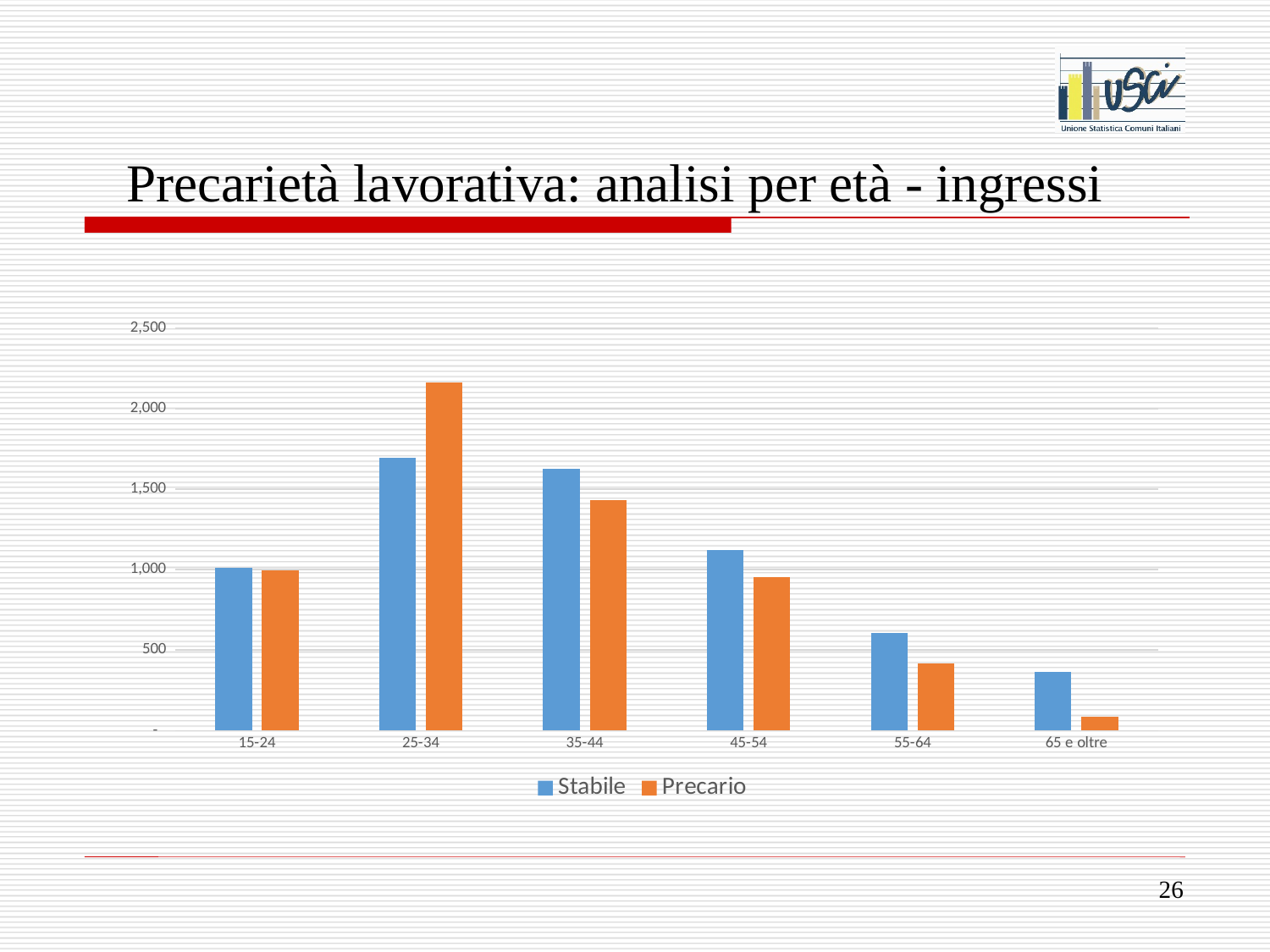
Is the Stabile value for 45-54 greater or less than 1,000? greater Which age group has the lowest Stabile value? 65 e oltre How many series does the chart's legend list? 2 What are the two series named in the chart's legend? Stabile and Precario Is the Precario value for 25-34 greater or less than 2,000? greater Which age group has the highest Precario value? 25-34 For the 65 e oltre age group, which series has the larger value, Stabile or Precario? Stabile Which age group has the lowest Precario value? 65 e oltre For the 25-34 age group, which series has the larger value, Stabile or Precario? Precario How many age groups are shown on the x axis of the chart? 6 What kind of chart is shown on the slide? bar chart Is the Precario value for 55-64 greater or less than 500? less